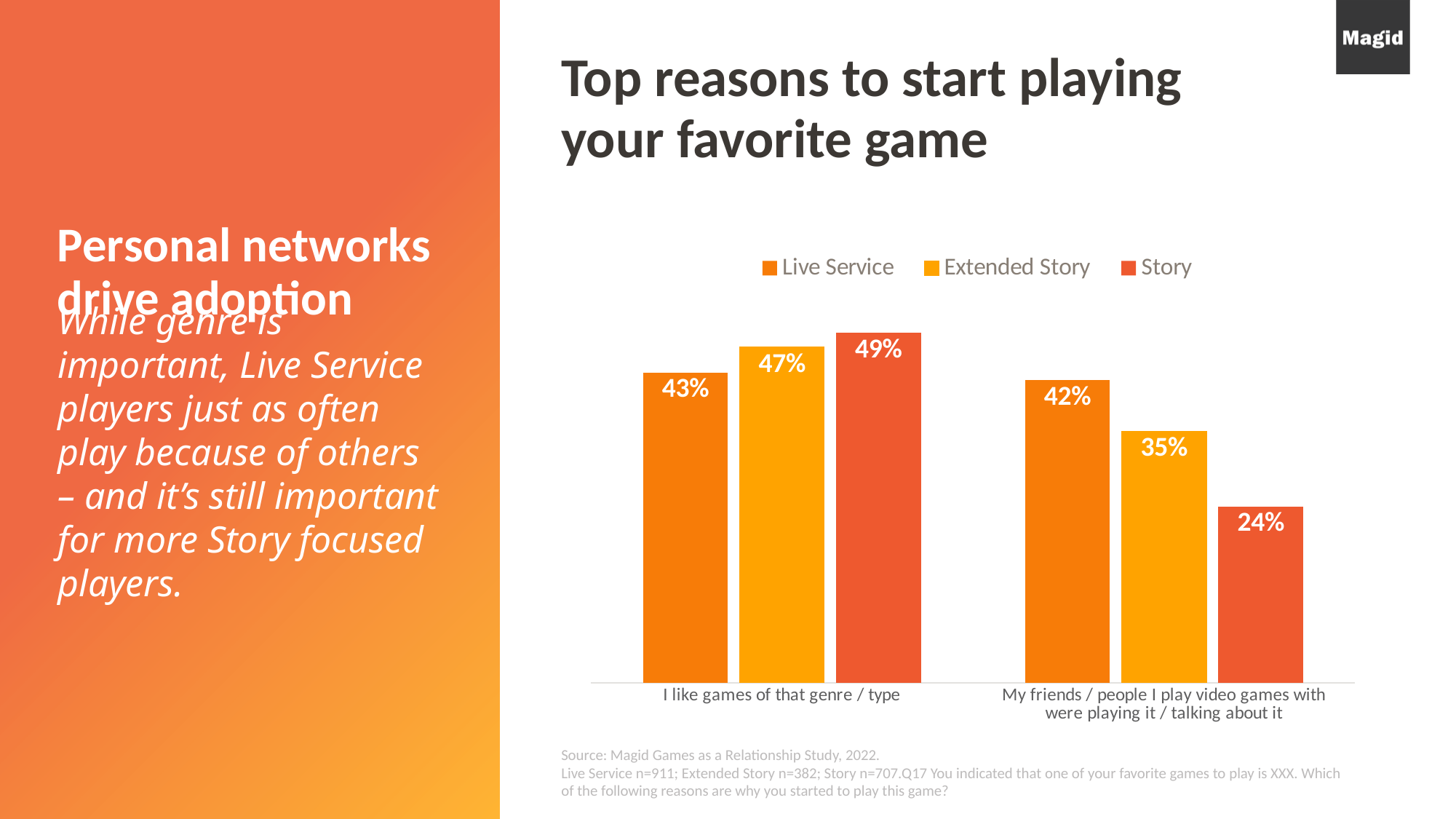
How many series does the legend list? 3 Which series has the highest value for "I like games of that genre / type"? Story What percentage of Story players cite "My friends / people I play video games with were playing it / talking about it"? 24% What kind of chart is shown on the slide? Bar chart What percentage of Live Service players cite "I like games of that genre / type" as a reason to start playing? 43% What is the value for Extended Story under "I like games of that genre / type"? 47% Which is larger: the Extended Story value for "I like games of that genre / type" or the Extended Story value for "My friends / people I play video games with were playing it / talking about it"? I like games of that genre / type What is the title of the chart? Top reasons to start playing your favorite game Which series has the lowest value for "My friends / people I play video games with were playing it / talking about it"? Story How many reason categories are shown on the x axis? 2 What is the difference between the Live Service and Story values for "My friends / people I play video games with were playing it / talking about it"? 18% Which legend entry is shown in yellow? Extended Story